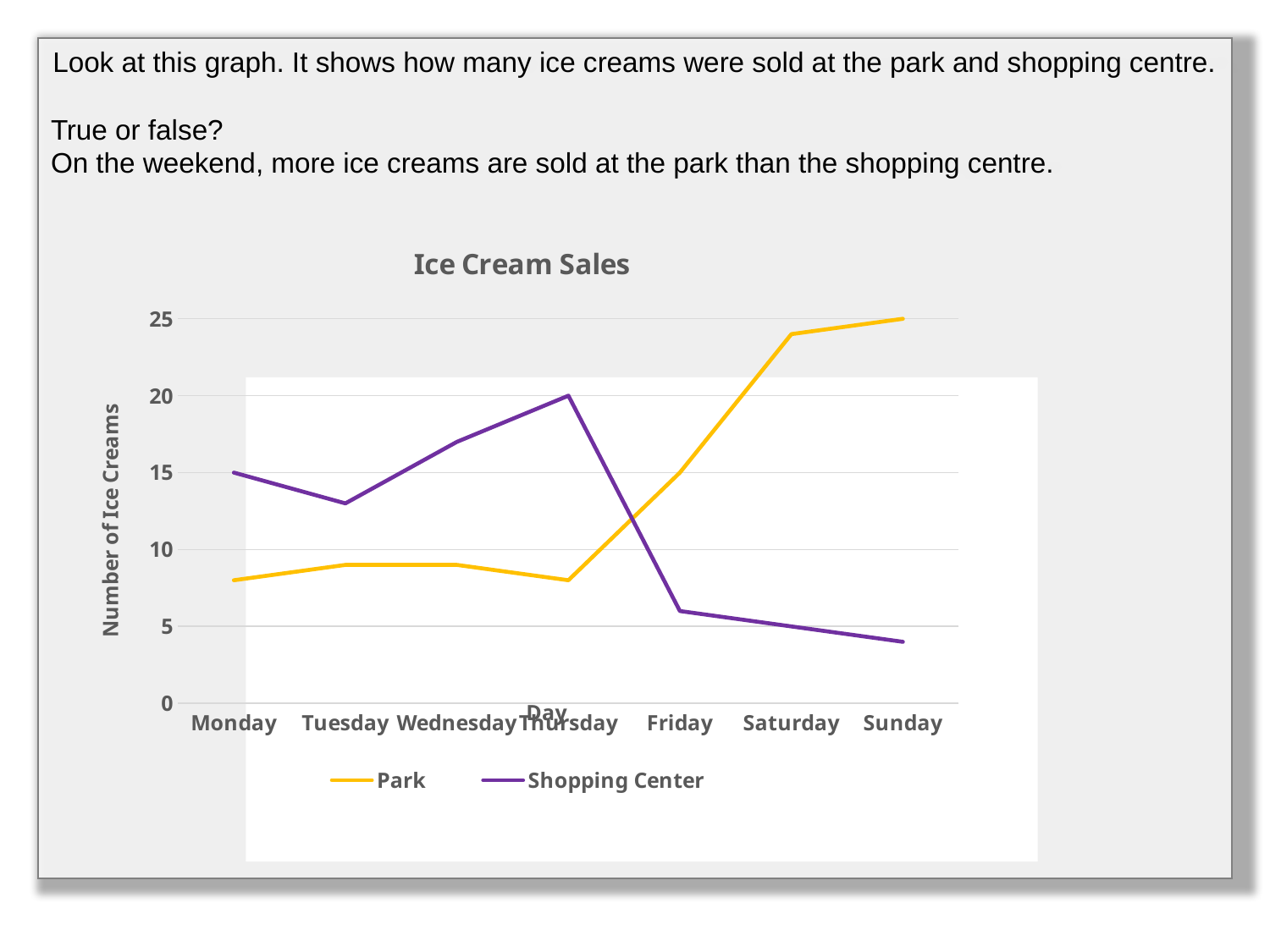
How many days are shown on the x axis? 7 What is the value for Shopping Center on Thursday? 20 Is the value for Park on Monday greater or less than 10? less What type of chart is shown on the slide? line chart Is the value for Shopping Center on Friday greater or less than 10? less How many series does the legend list? 2 Is the value for Park on Saturday greater or less than 20? greater What is the value for Shopping Center on Monday? 15 Does the Shopping Center line rise or fall from Thursday to Sunday? fall On which day is the Shopping Center value highest? Thursday On Friday, which series has the larger value, Park or Shopping Center? Park What is the value for Park on Sunday? 25